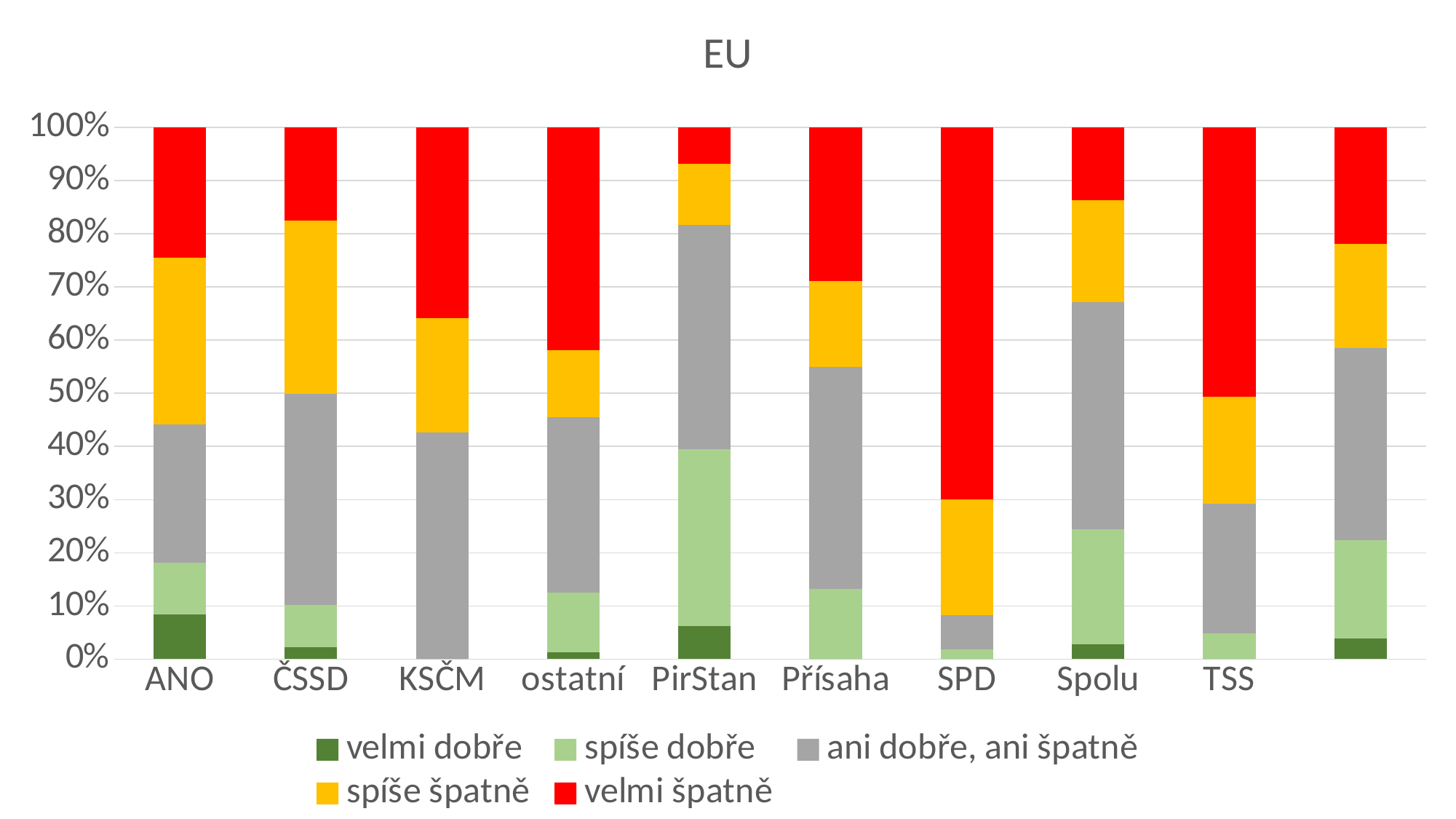
Is the 'velmi špatně' share for SPD greater or less than 60%? greater What type of chart is shown on the slide? stacked bar chart Which party has the smallest 'velmi špatně' share? PirStan How many bars are plotted in the chart? 10 Is the 'spíše dobře' share for PirStan greater or less than 30%? greater Is the 'velmi dobře' share for ANO greater or less than 10%? less What colour represents 'velmi špatně' in the chart? red What is the title of the chart? EU Which party has the largest 'velmi špatně' share? SPD Which has a larger 'velmi špatně' share, ANO or KSČM? KSČM How many series does the legend list? 5